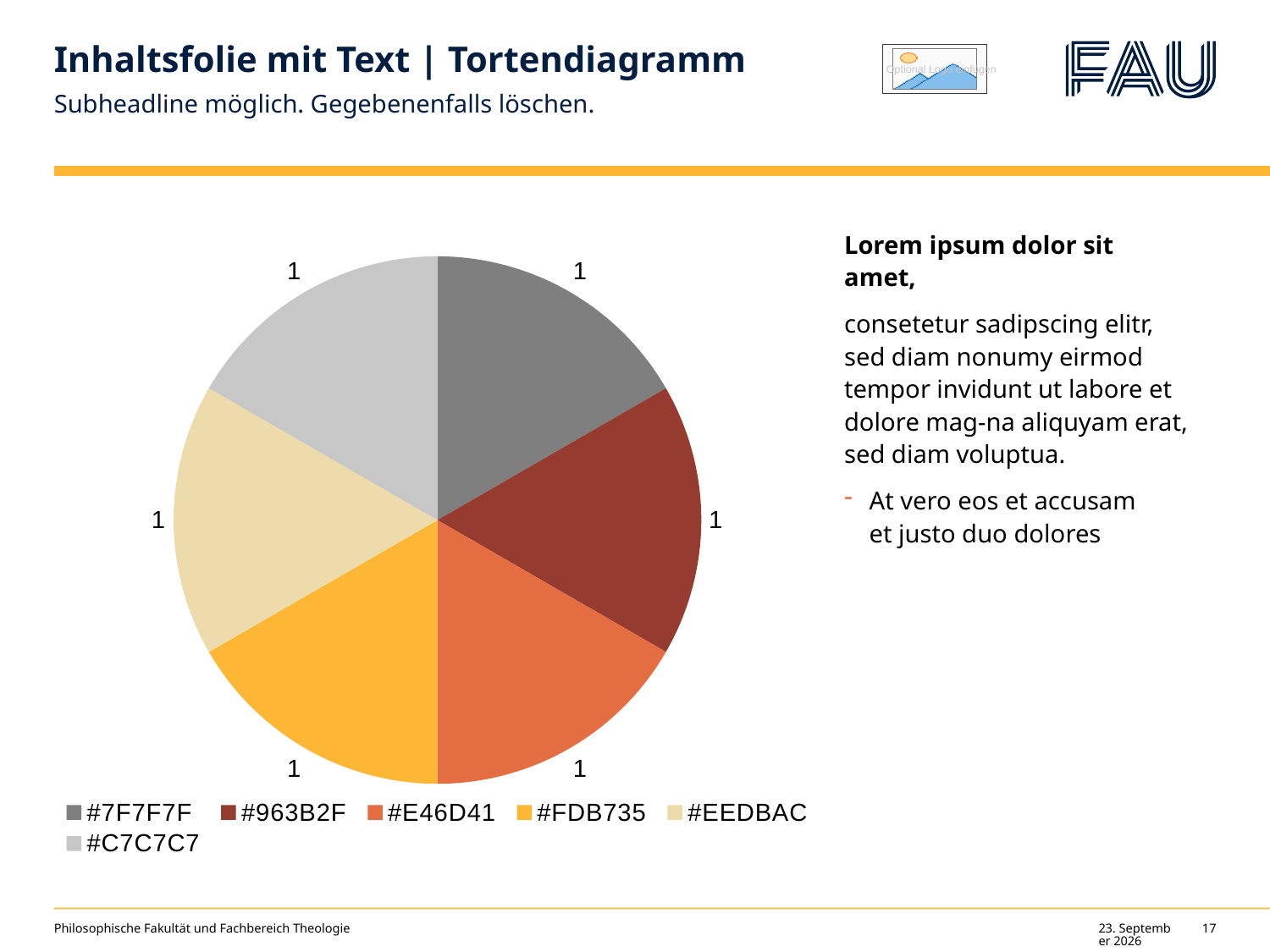
What is the total of all slice values in the pie chart? 6 What kind of chart is shown on the slide? pie chart What share of the pie does the #7F7F7F slice represent? 1/6 How many entries does the legend of the pie chart list? 6 What is the value of the #963B2F slice in the pie chart? 1 What is the value of the #C7C7C7 slice in the pie chart? 1 How many slices does the pie chart have? 6 What is the difference between the values of the #E46D41 and #EEDBAC slices? 0 Which legend entry is listed first in the pie chart's legend? #7F7F7F Which legend entry is listed last in the pie chart's legend? #C7C7C7 What is the value of the #FDB735 slice in the pie chart? 1 What is the value of the #7F7F7F slice in the pie chart? 1